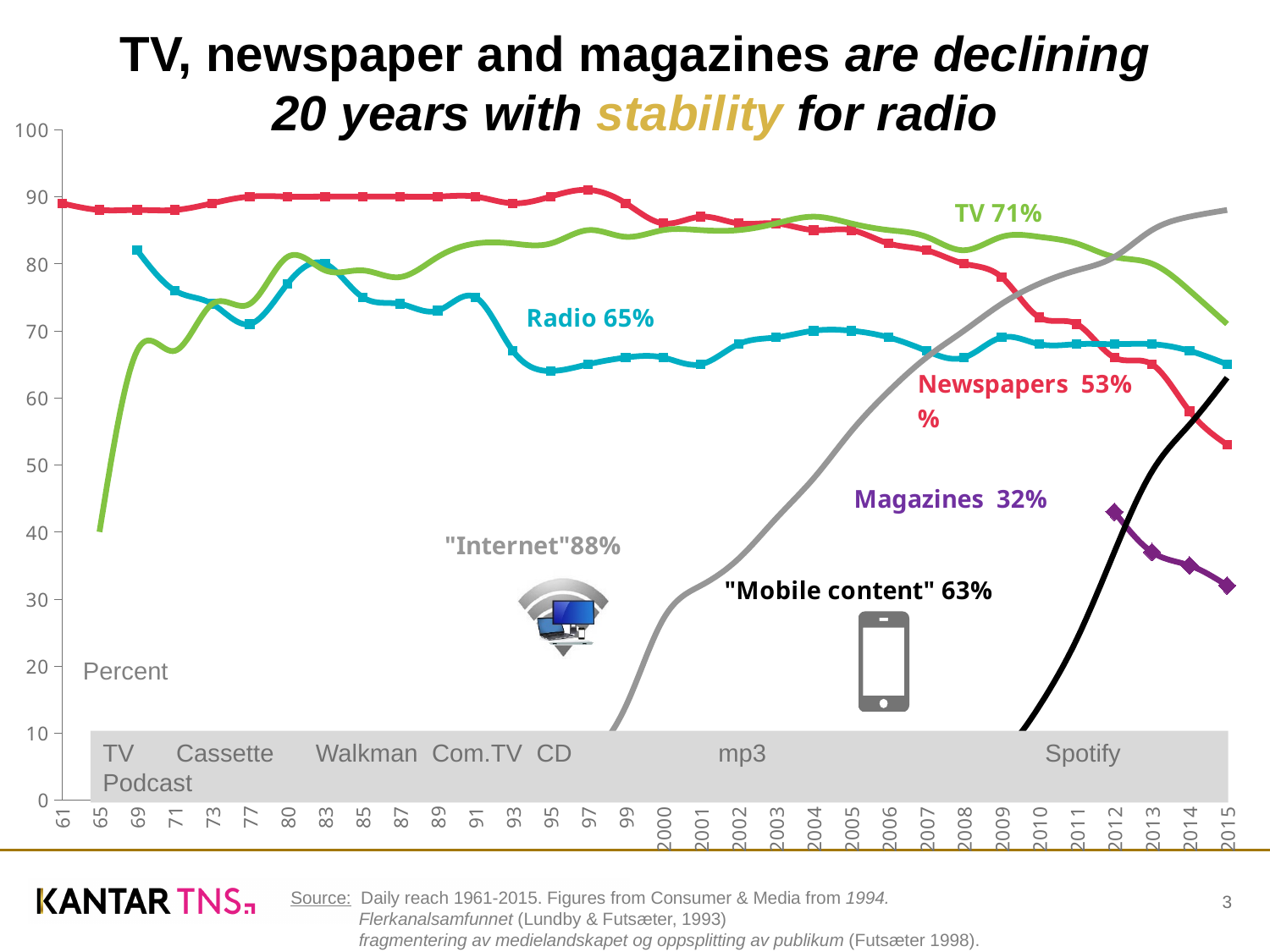
What value is printed in the label for Radio? 65% What value is printed in the label for "Mobile content"? 63% What kind of chart is shown on the slide? line chart What value is printed in the label for Magazines? 32% Is the value of the Newspapers line in 1961 greater or less than 80? greater Which labelled series has the lowest printed value? Magazines (32%) Does the Newspapers line rise or fall between 2005 and 2015? fall What value is printed in the label for Newspapers? 53% Which labelled series has the highest printed value? "Internet" (88%) What is the difference between the printed values for TV and Radio? 6 percentage points Which has the larger printed value, Newspapers or "Mobile content"? "Mobile content" What value is printed in the label for TV? 71%